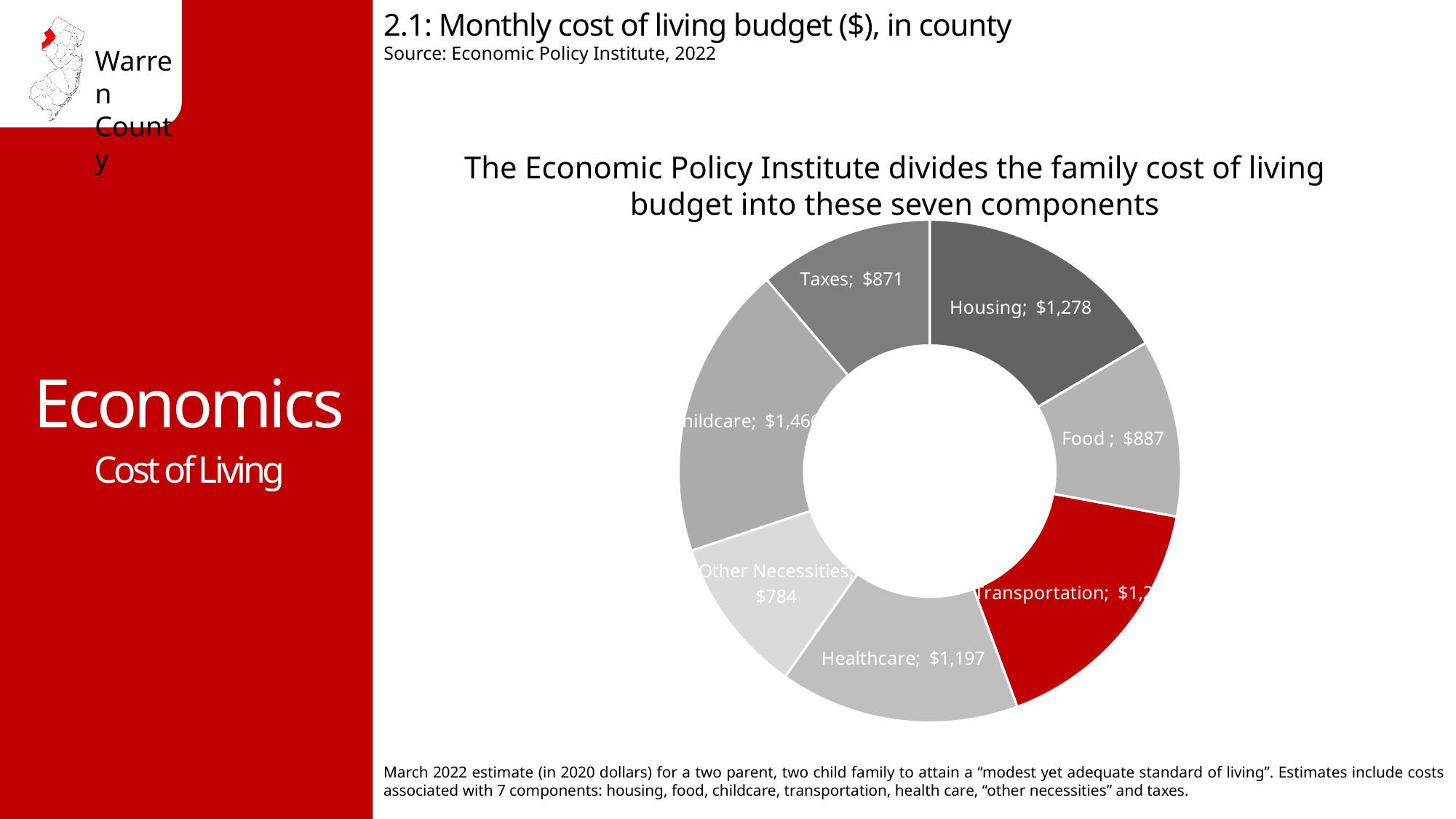
What type of chart is shown on the slide? Doughnut chart How much larger is the Housing cost than the Food cost? $391 Which is larger, the Housing cost or the Healthcare cost? Housing Which component has the smallest monthly cost on the chart? Other Necessities What is the monthly cost for Healthcare shown on the chart? $1,197 How many components are shown in the chart? 7 Which component has the largest slice of the chart? Childcare What is the monthly cost for Housing shown on the chart? $1,278 What is the monthly cost for Other Necessities shown on the chart? $784 What is the monthly cost for Taxes shown on the chart? $871 What is the monthly cost for Food shown on the chart? $887 What is the difference between the Healthcare cost and the Taxes cost? $326